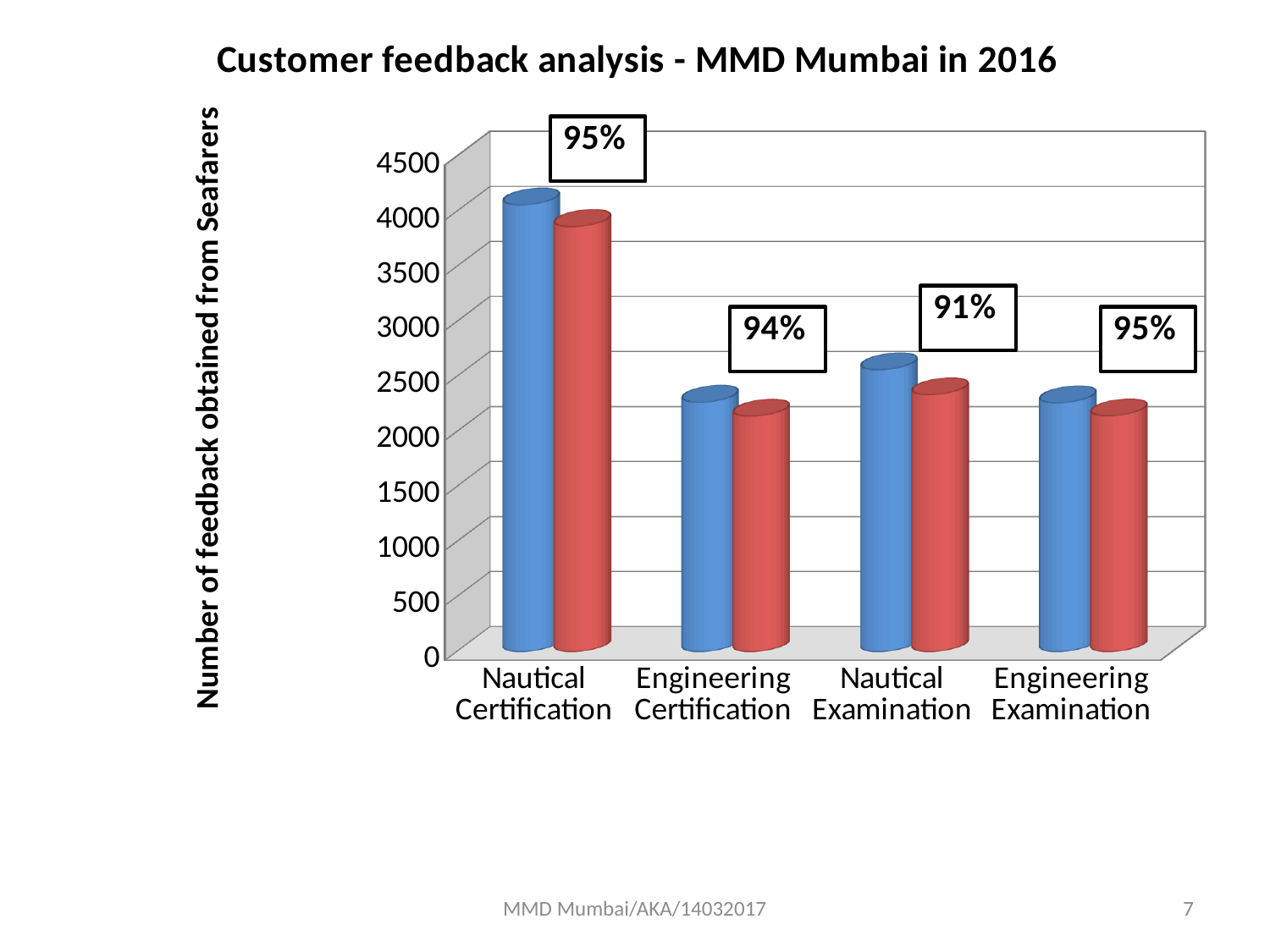
Is the value of the blue bar for Engineering Certification greater or less than 2500? less What is the title of the chart? Customer feedback analysis - MMD Mumbai in 2016 What percentage is shown above the Engineering Certification bars? 94% What is the label on the vertical axis of the chart? Number of feedback obtained from Seafarers Which category has the highest bars in the chart? Nautical Certification How many categories are shown on the x axis of the chart? 4 What percentage is shown above the Nautical Certification bars? 95% Is the value of the blue bar for Nautical Examination greater or less than 3000? less What percentage is shown above the Nautical Examination bars? 91% What kind of chart is shown on the slide? Bar chart Which is larger, the blue bar for Nautical Certification or the blue bar for Nautical Examination? Nautical Certification Is the value of the blue bar for Nautical Certification greater or less than 3500? greater